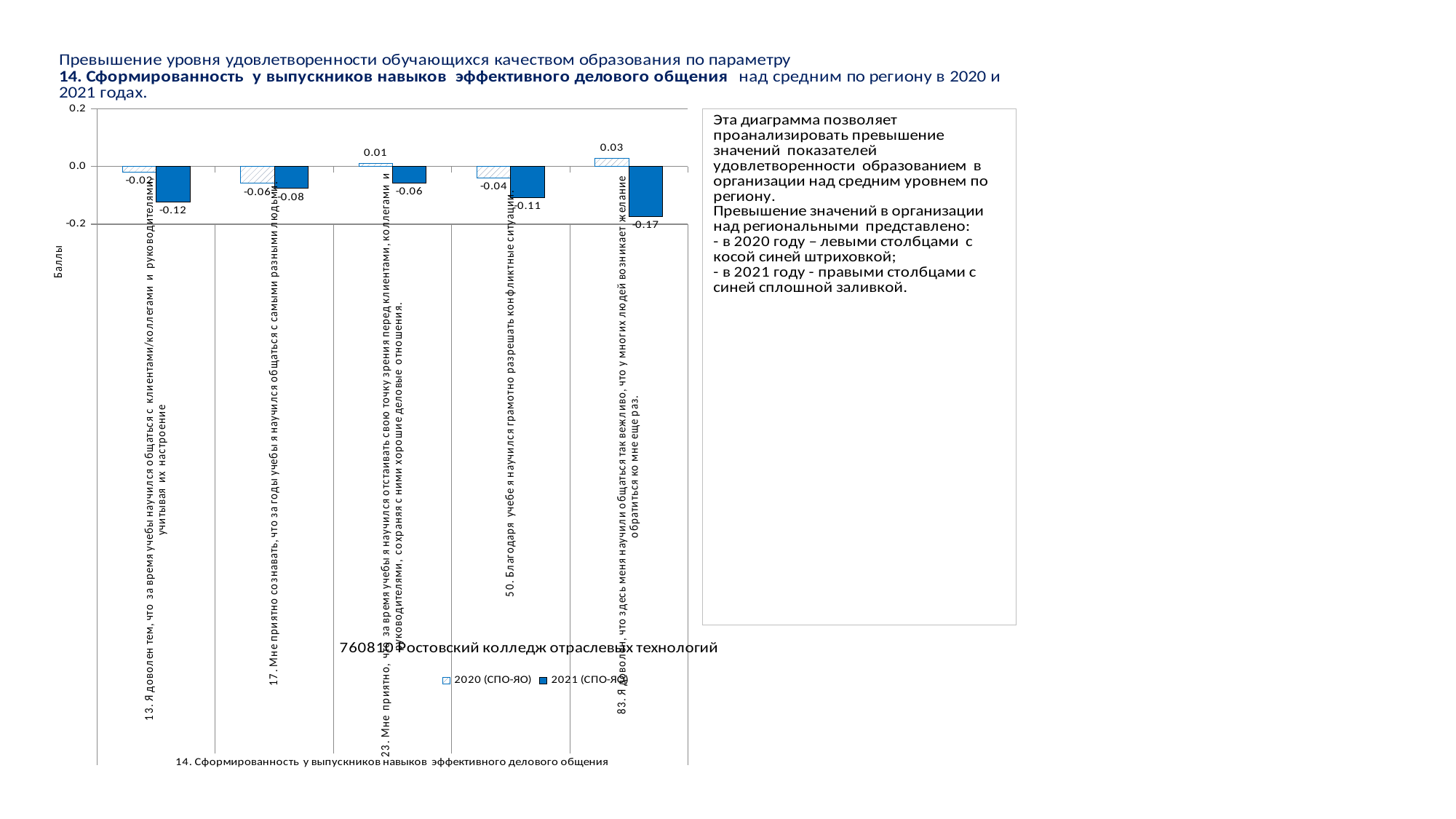
What is the 2021 (СПО-ЯО) value for statement 50 ("Благодаря учебе я научился грамотно разрешать конфликтные ситуации")? -0.11 What is the 2020 (СПО-ЯО) value for statement 23 ("Мне приятно, что за время учебы я научился отстаивать свою точку зрения...")? 0.01 What is the difference between the 2020 and 2021 values for statement 17 ("Мне приятно сознавать, что за годы учебы я научился общаться с самыми разными людьми")? 0.02 What kind of chart is shown on the slide? bar chart For statement 13, which is larger: the 2020 (СПО-ЯО) value or the 2021 (СПО-ЯО) value? 2020 (СПО-ЯО) Which statement has the lowest 2021 (СПО-ЯО) value? 83. Я доволен, что здесь меня научили общаться так вежливо, что у многих людей возникает желание обратиться ко мне еще раз. How many series does the chart legend list? 2 According to the legend, which series is shown with the solid blue fill? 2021 (СПО-ЯО) What is the 2020 (СПО-ЯО) value for statement 83 ("Я доволен, что здесь меня научили общаться так вежливо...")? 0.03 What is the 2021 (СПО-ЯО) value for statement 13 ("Я доволен тем, что за время учебы научился общаться с клиентами/коллегами...")? -0.12 Which statement has the highest 2020 (СПО-ЯО) value? 83. Я доволен, что здесь меня научили общаться так вежливо, что у многих людей возникает желание обратиться ко мне еще раз. How many categories (statements) are plotted on the chart? 5